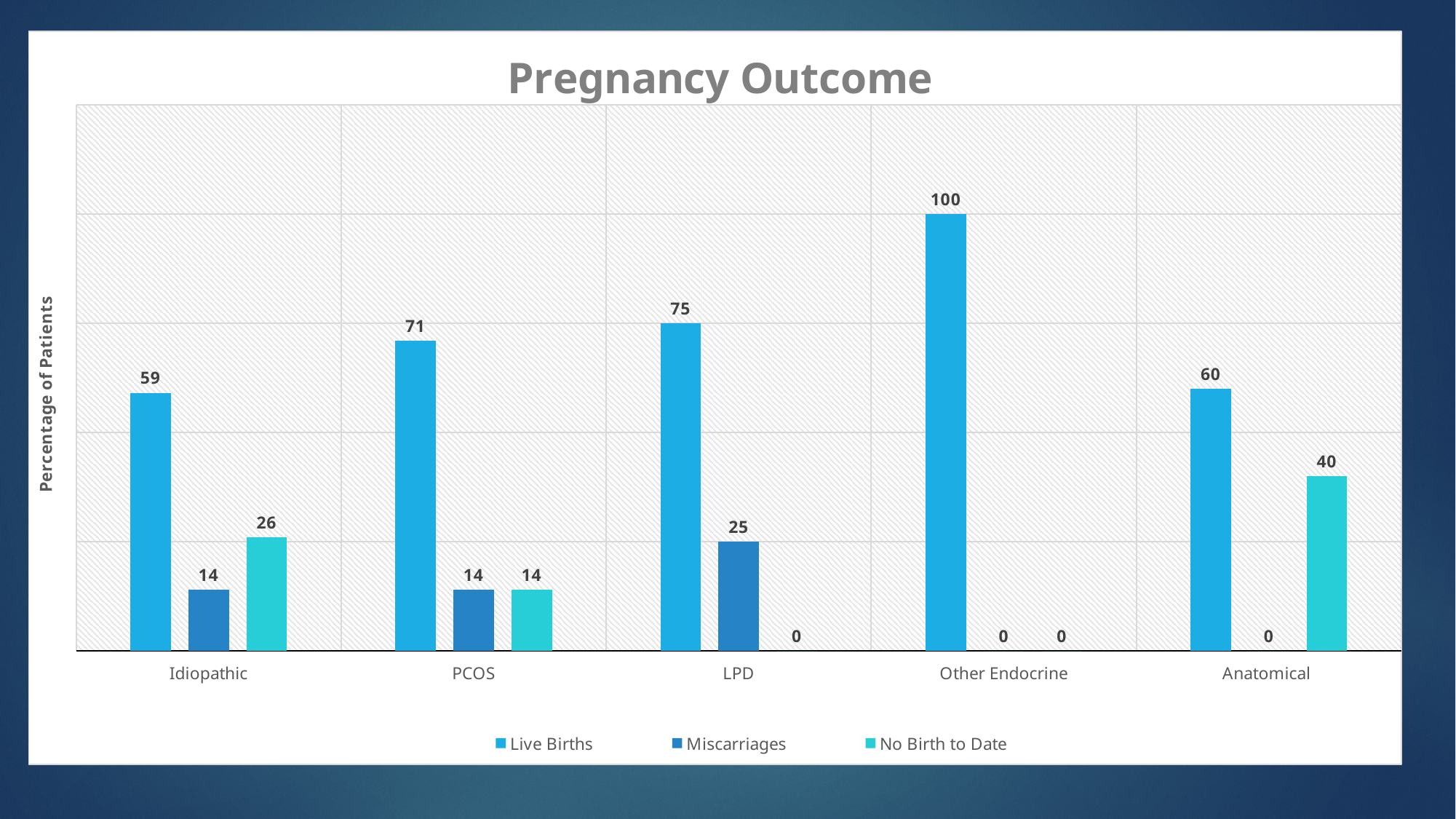
How many categories are shown on the x axis? 5 What is the No Birth to Date value for Anatomical? 40 What is the Live Births value for PCOS? 71 Which category has the highest Live Births value? Other Endocrine What is the difference between the Live Births values for LPD and Idiopathic? 16 What is the Miscarriages value for LPD? 25 Which is larger, the No Birth to Date value for Idiopathic or for Anatomical? Anatomical Which category has the lowest Live Births value? Idiopathic What kind of chart is shown on the slide? Bar chart What is the label of the vertical axis? Percentage of Patients What is the title of the chart? Pregnancy Outcome How many series does the legend list? 3